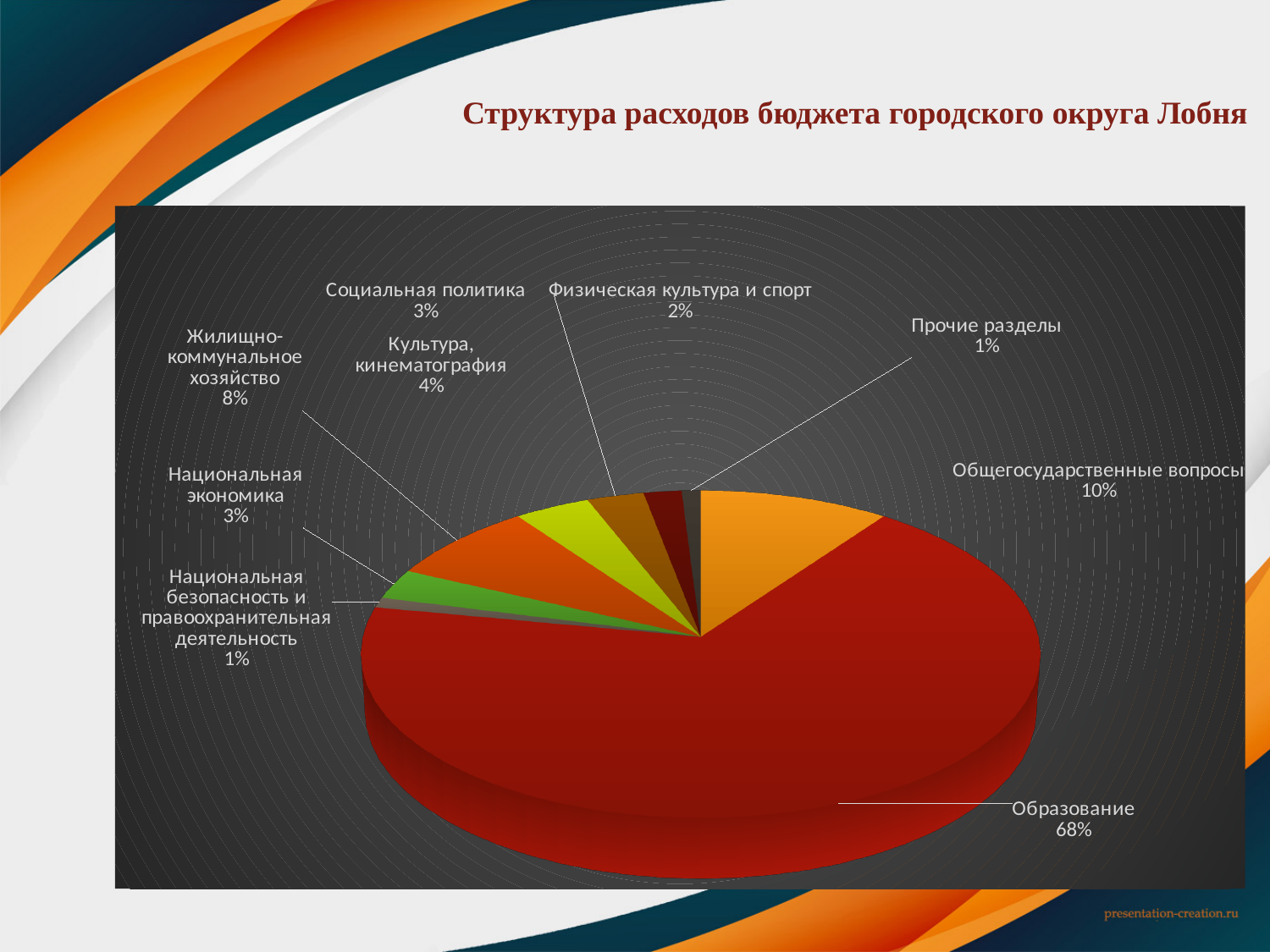
Сколько разделов расходов показано на диаграмме? 9 Какова сумма долей «Социальная политика» и «Национальная экономика»? 6% Какую долю составляет «Культура, кинематография»? 4% Какая доля приходится на «Физическая культура и спорт»? 2% Какая доля приходится на «Жилищно-коммунальное хозяйство»? 8% Как называется диаграмма на слайде? Структура расходов бюджета городского округа Лобня Какую долю расходов бюджета составляет «Образование»? 68% Какую долю составляют «Общегосударственные вопросы»? 10% Какого типа эта диаграмма? Круговая диаграмма Что больше: доля «Жилищно-коммунальное хозяйство» или доля «Культура, кинематография»? Жилищно-коммунальное хозяйство Какой раздел расходов имеет наибольшую долю? Образование На сколько процентных пунктов доля «Образование» больше доли «Общегосударственные вопросы»? 58